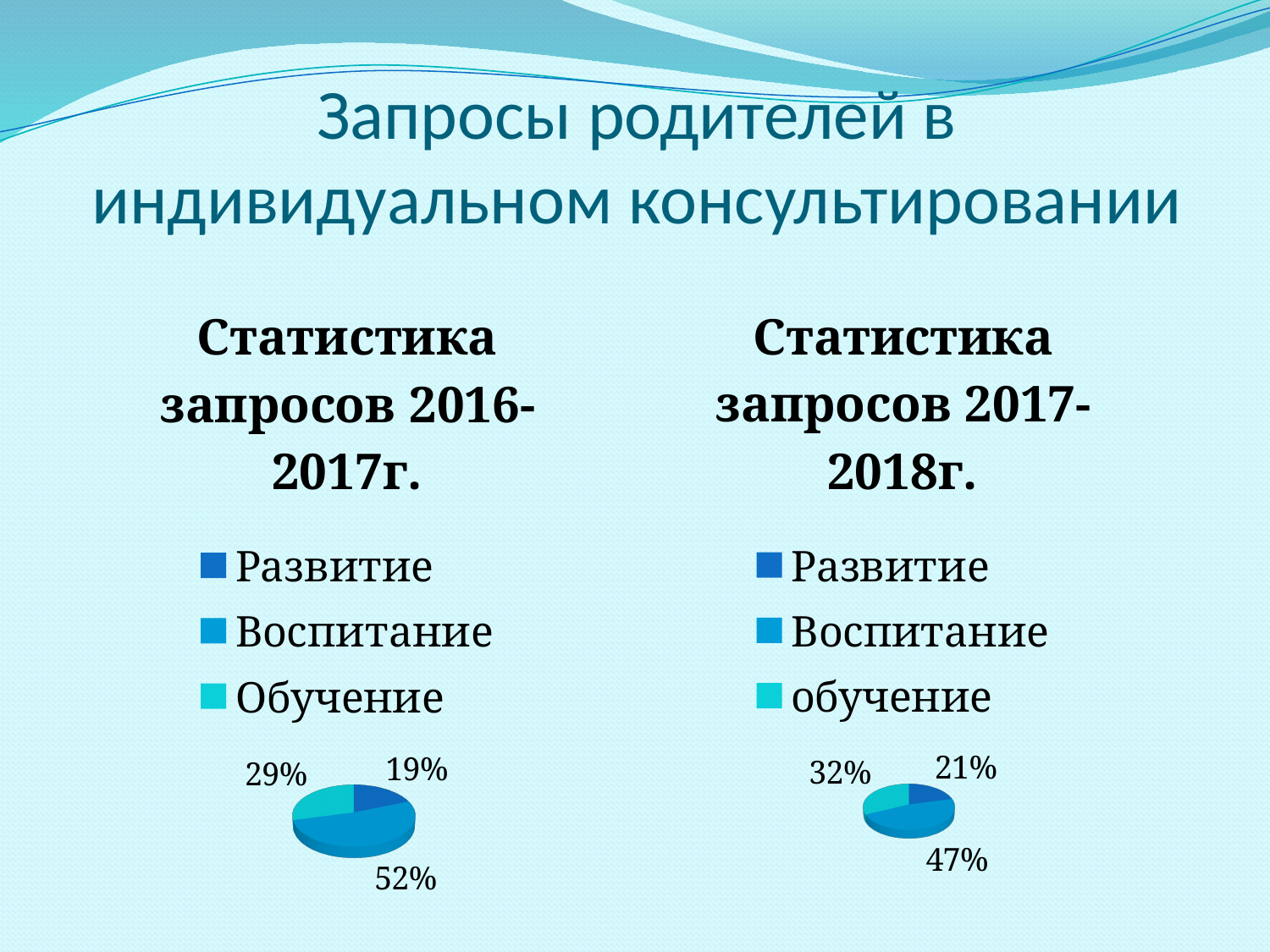
In the chart titled "Статистика запросов 2016-2017г.", which category has the largest slice? Воспитание In the chart titled "Статистика запросов 2017-2018г.", what share does обучение have? 32% In the chart titled "Статистика запросов 2016-2017г.", what share does Развитие have? 19% In the chart titled "Статистика запросов 2016-2017г.", what is the difference between the shares of Воспитание and Обучение? 23% In the chart titled "Статистика запросов 2017-2018г.", what share does Воспитание have? 47% How many categories does the legend of the chart titled "Статистика запросов 2017-2018г." list? 3 In the chart titled "Статистика запросов 2016-2017г.", what share does Воспитание have? 52% In the chart titled "Статистика запросов 2017-2018г.", which is larger: the share of обучение or the share of Развитие? обучение What kind of chart is the chart titled "Статистика запросов 2016-2017г."? Pie chart In the chart titled "Статистика запросов 2017-2018г.", what is the difference between the shares of Воспитание and Развитие? 26% How many charts are shown on the slide? 2 In the chart titled "Статистика запросов 2017-2018г.", which category has the smallest slice? Развитие